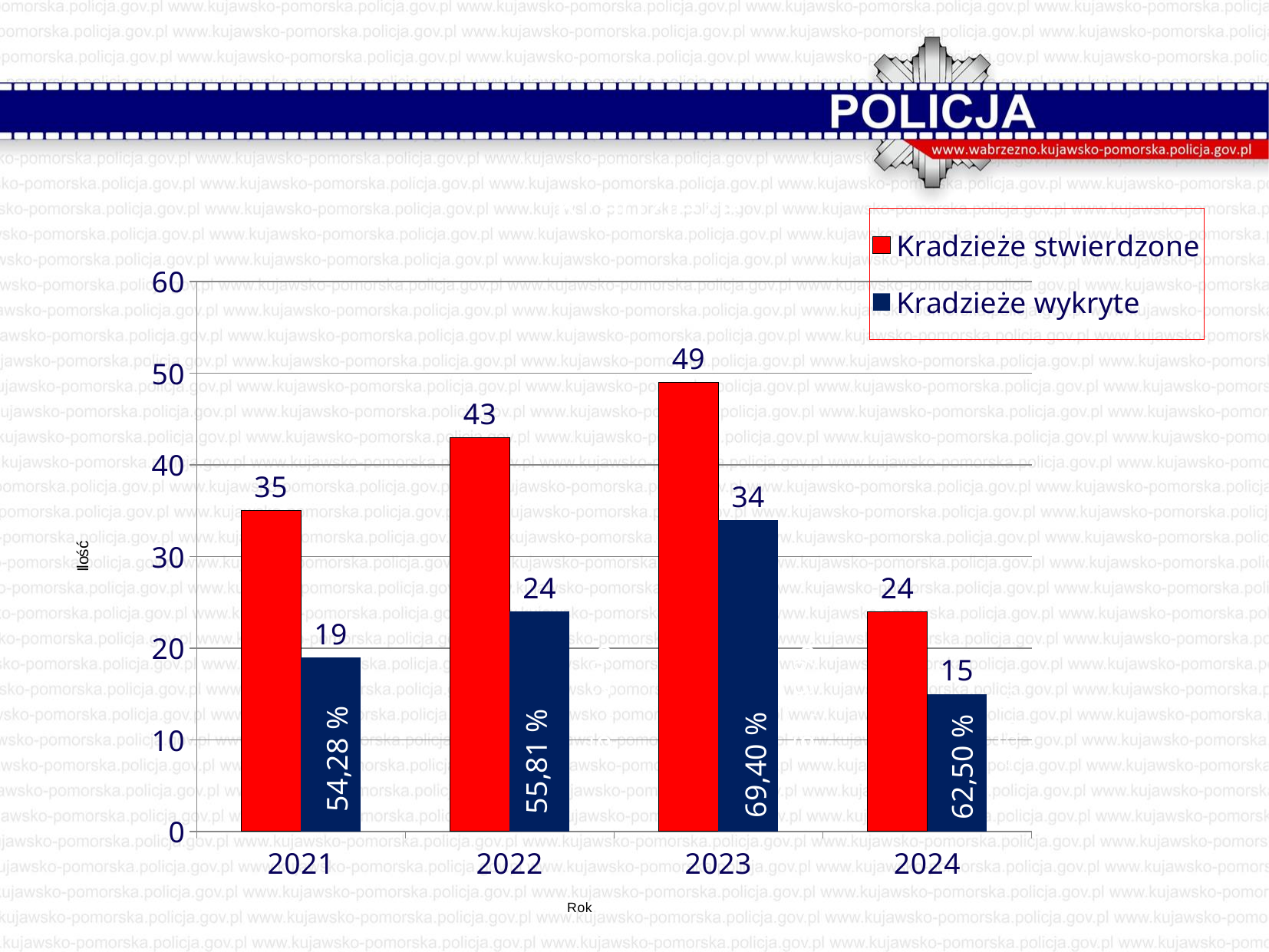
Which year has the lowest value for Kradzieże wykryte? 2024 What is the difference between Kradzieże stwierdzone and Kradzieże wykryte in 2022? 19 Is the value of Kradzieże wykryte for 2023 greater or less than 30? greater Which is larger: Kradzieże stwierdzone in 2021 or Kradzieże stwierdzone in 2024? 2021 Which year has the highest value for Kradzieże stwierdzone? 2023 What is the value of Kradzieże stwierdzone for 2023? 49 How many series does the legend list? 2 How many years are shown on the x axis? 4 What percentage label is shown on the Kradzieże wykryte bar for 2024? 62,50 % What is the value of Kradzieże wykryte for 2021? 19 What colour are the Kradzieże stwierdzone bars? red What kind of chart is shown on the slide? bar chart